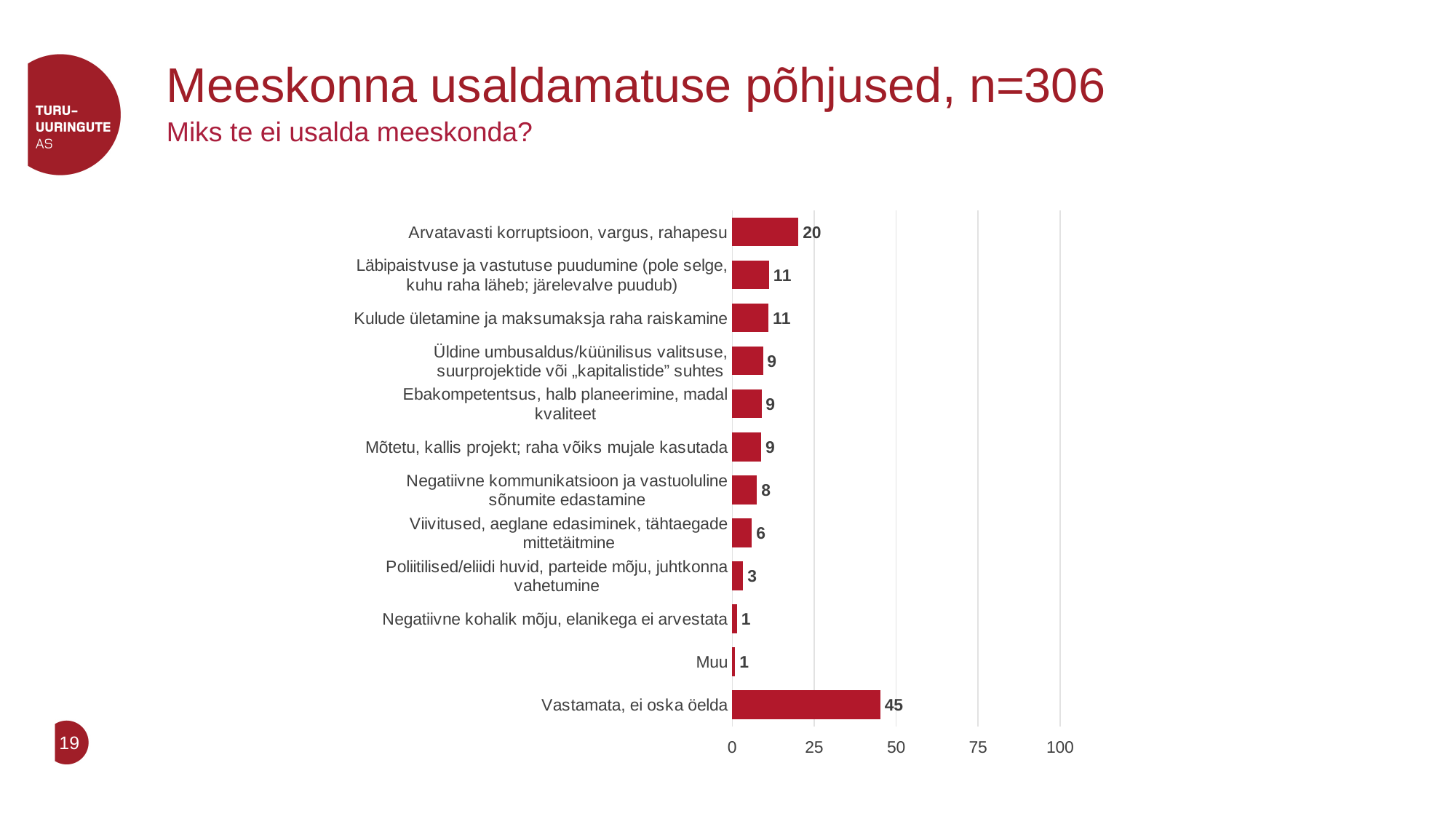
What is the value for "Arvatavasti korruptsioon, vargus, rahapesu"? 20 Which category has the highest value? Vastamata, ei oska öelda What kind of chart is shown on the slide? bar chart What is the value for "Poliitilised/eliidi huvid, parteide mõju, juhtkonna vahetumine"? 3 What is the title of the slide? Meeskonna usaldamatuse põhjused, n=306 What is the difference between the values for "Vastamata, ei oska öelda" and "Arvatavasti korruptsioon, vargus, rahapesu"? 25 How many categories are shown in the chart? 12 What is the difference between the values for "Kulude ületamine ja maksumaksja raha raiskamine" and "Negatiivne kommunikatsioon ja vastuoluline sõnumite edastamine"? 3 Is the value for "Vastamata, ei oska öelda" greater or less than 50? less What is the value for "Viivitused, aeglane edasiminek, tähtaegade mittetäitmine"? 6 What is the value for "Vastamata, ei oska öelda"? 45 Which is larger: the value for "Arvatavasti korruptsioon, vargus, rahapesu" or the value for "Kulude ületamine ja maksumaksja raha raiskamine"? Arvatavasti korruptsioon, vargus, rahapesu